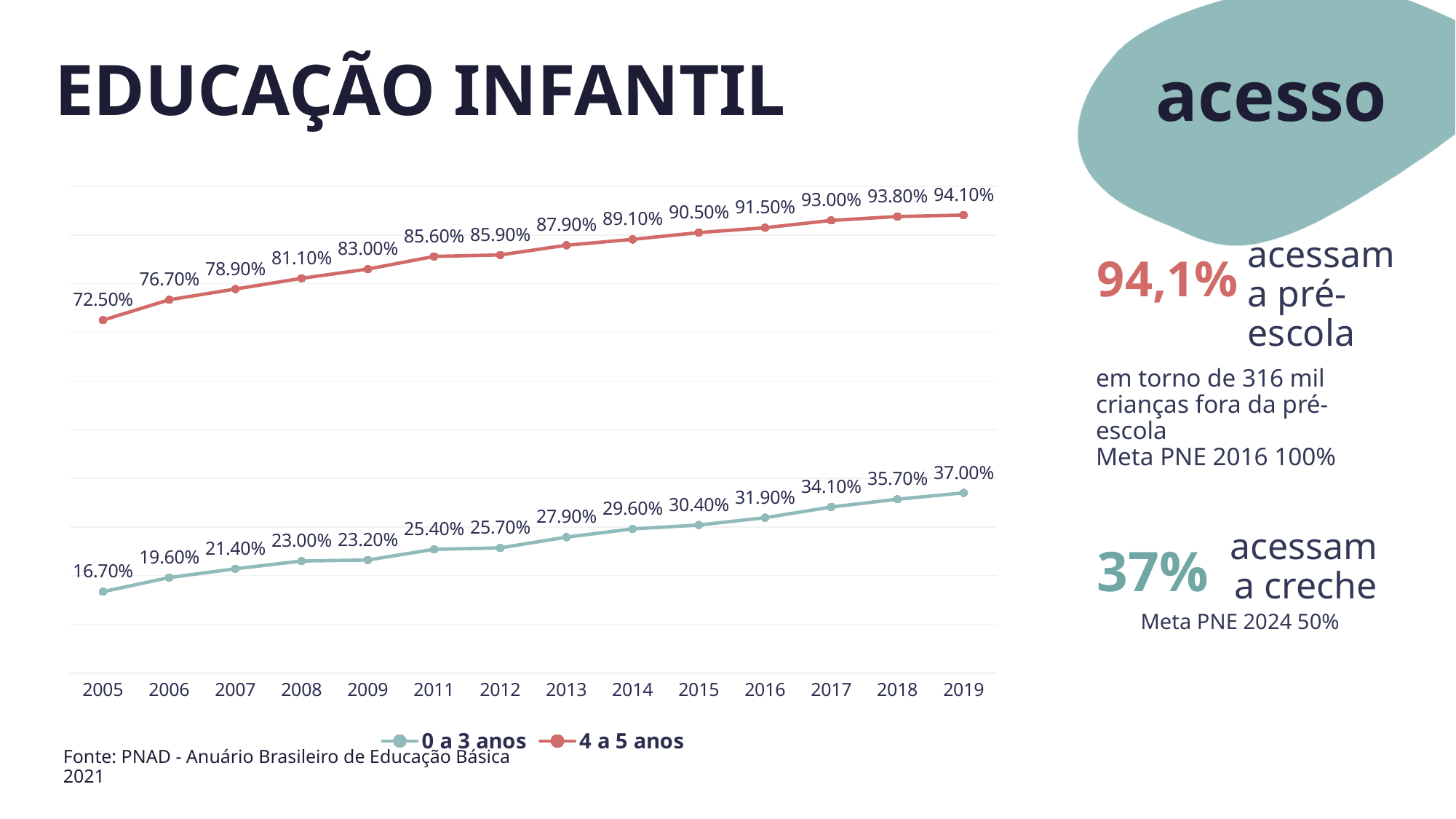
How many series does the legend list? 2 What is the value for '0 a 3 anos' in 2019? 37.00% Which series is higher in 2011, '0 a 3 anos' or '4 a 5 anos'? 4 a 5 anos What is the value for '4 a 5 anos' in 2005? 72.50% In which year is the '4 a 5 anos' series at its highest? 2019 Do the values for '0 a 3 anos' rise or fall from 2005 to 2019? Rise In which year is the '0 a 3 anos' series at its lowest? 2005 What is the value for '4 a 5 anos' in 2015? 90.50% How many years are plotted along the x axis? 14 What is the value for '0 a 3 anos' in 2013? 27.90% What is the difference between the '4 a 5 anos' value and the '0 a 3 anos' value in 2019? 57.10% What type of chart is shown on the slide? Line chart